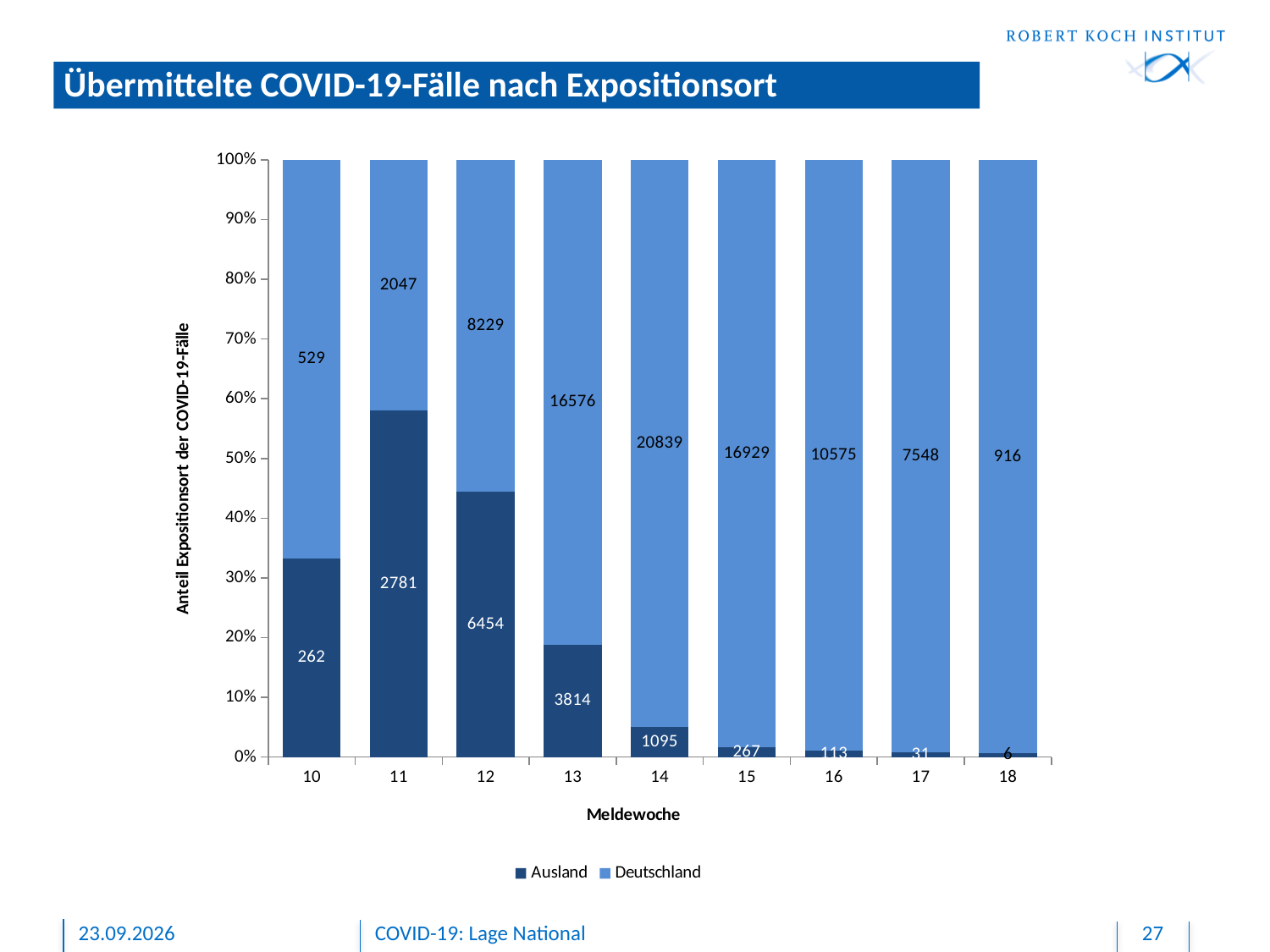
What is the total number of cases (Ausland plus Deutschland) in Meldewoche 10? 791 How many Meldewoche categories are shown on the x axis? 9 Which is larger in Meldewoche 11, the Ausland value or the Deutschland value? Ausland Is the Ausland share of cases in Meldewoche 11 greater or less than 50%? greater How many series does the legend list? 2 What is the Ausland value for Meldewoche 18? 6 Which Meldewoche has the lowest Ausland value? 18 What is the difference between the Deutschland and Ausland values in Meldewoche 13? 12762 What is the Deutschland value for Meldewoche 14? 20839 Which Meldewoche has the highest Deutschland value? 14 What type of chart is shown on the slide? stacked bar chart What is the Ausland value for Meldewoche 12? 6454